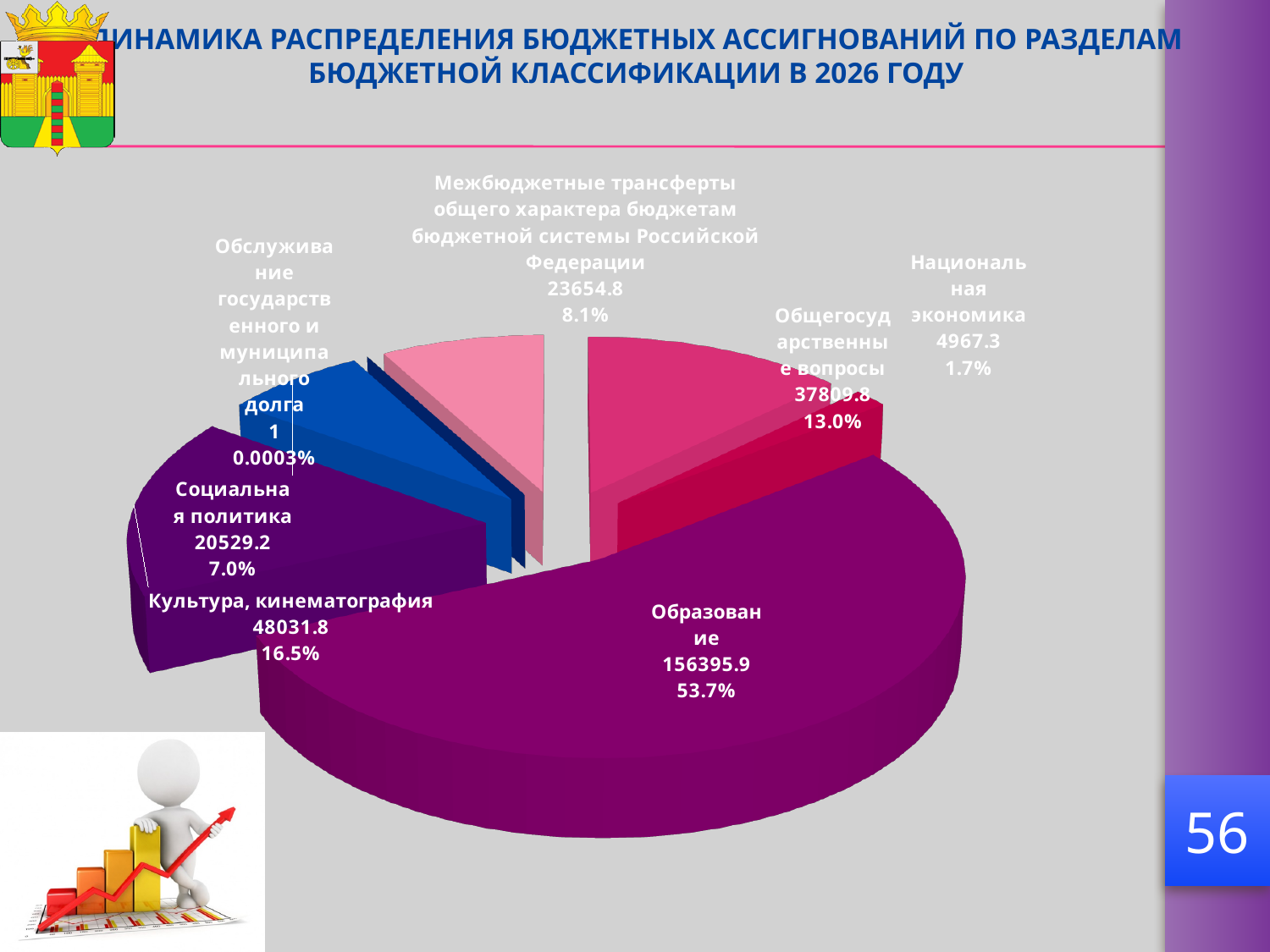
What kind of chart is shown on the slide? pie chart What value is shown for Образование? 156395.9 What value is shown for Национальная экономика? 4967.3 What percentage is shown for Общегосударственные вопросы? 13.0% Which is larger, the value for Социальная политика or the value for Межбюджетные трансферты общего характера бюджетам бюджетной системы Российской Федерации? Межбюджетные трансферты общего характера бюджетам бюджетной системы Российской Федерации What is the difference between the values for Культура, кинематография and Общегосударственные вопросы? 10222.0 How many slices does the pie chart have? 7 What percentage is shown for Социальная политика? 7.0% What value is shown for Культура, кинематография? 48031.8 What share of the pie does Образование represent? 53.7% Which category has the smallest slice of the pie? Обслуживание государственного и муниципального долга Which category has the largest slice of the pie? Образование